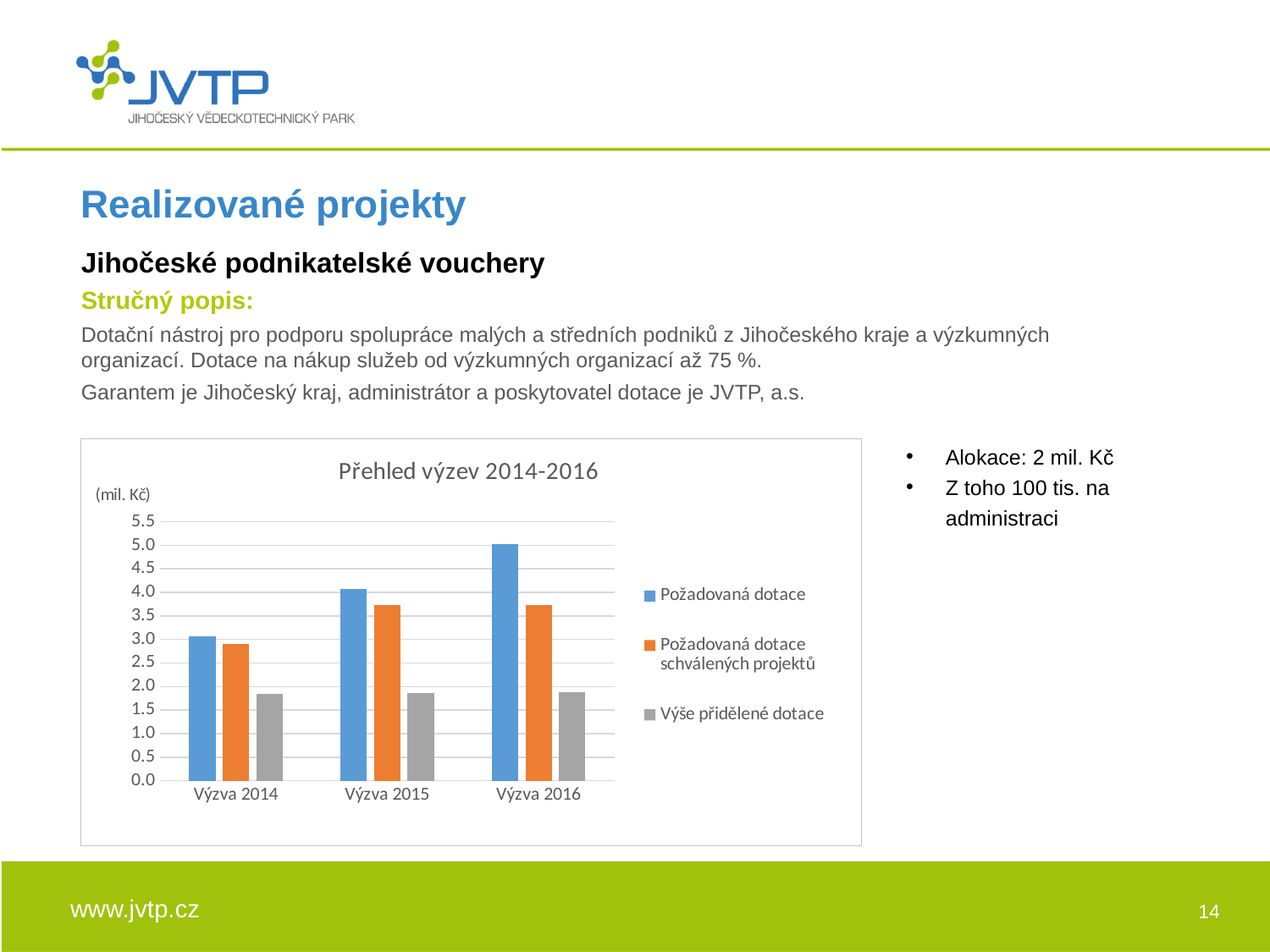
Which is larger: Požadovaná dotace schválených projektů for Výzva 2014 or for Výzva 2015? Výzva 2015 Is the value of Výše přidělené dotace for Výzva 2014 greater or less than 2.0? less Is the value of Požadovaná dotace for Výzva 2016 greater or less than 4.5? greater How many categories are shown on the x axis of the chart? 3 Which category has the highest value for Požadovaná dotace? Výzva 2016 How many series does the chart legend list? 3 Which category has the lowest value for Požadovaná dotace? Výzva 2014 Does the value of Požadovaná dotace rise or fall from Výzva 2014 to Výzva 2016? rise In which unit are the values on the chart's y axis given? mil. Kč What type of chart is shown on the slide? bar chart Is the value of Požadovaná dotace schválených projektů for Výzva 2015 greater or less than 3.5? greater What is the title of the chart? Přehled výzev 2014-2016